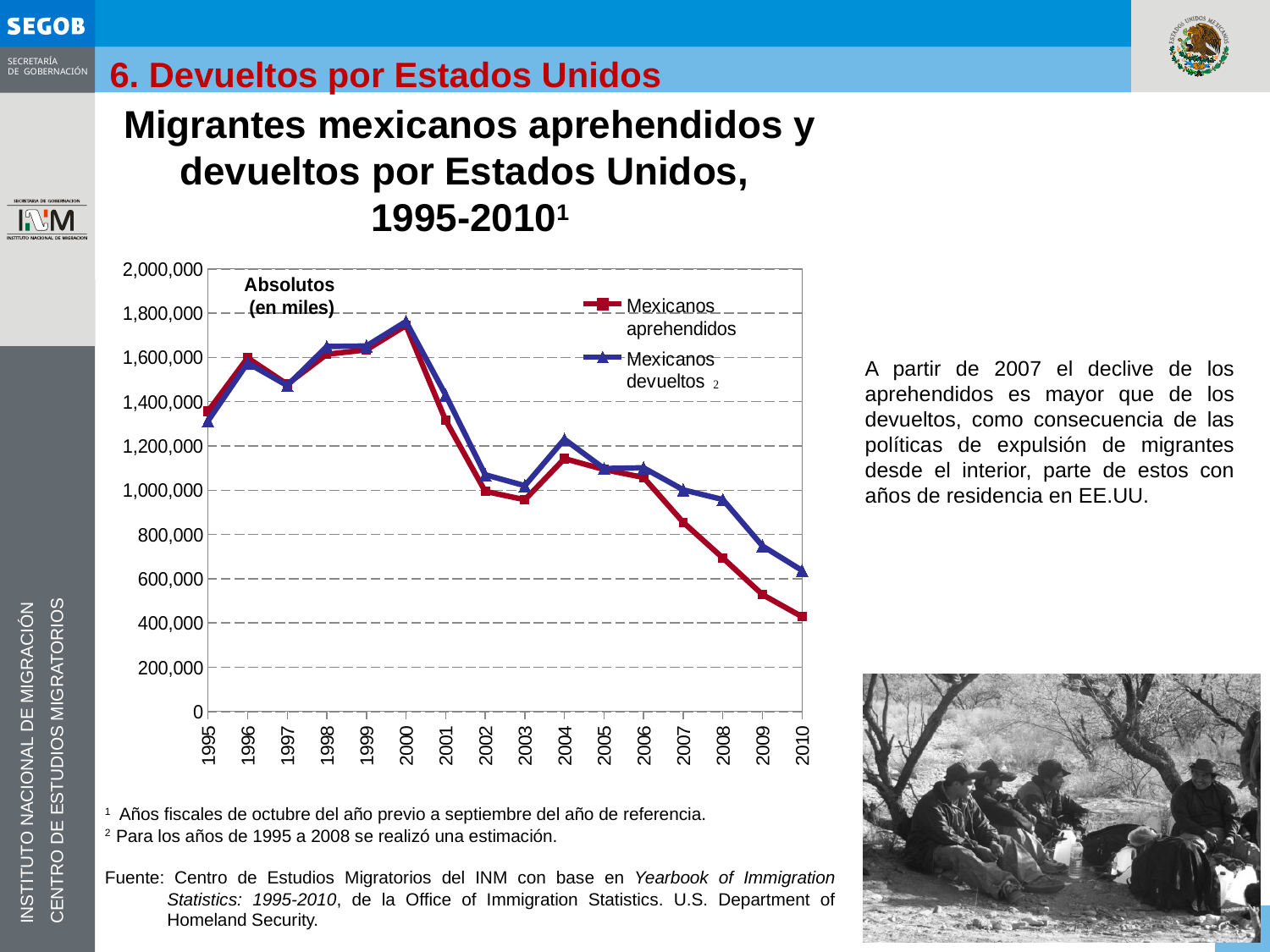
In 2010, which series has the larger value: 'Mexicanos aprehendidos' or 'Mexicanos devueltos'? Mexicanos devueltos Which series is drawn in red on the chart? Mexicanos aprehendidos Is the value for 'Mexicanos devueltos' in 2004 greater or less than 1,000,000? greater Is the value for 'Mexicanos aprehendidos' in 2000 greater or less than 1,600,000? greater In which year does the 'Mexicanos aprehendidos' series reach its highest value? 2000 From 2007 to 2010, do the values of the 'Mexicanos aprehendidos' series rise or fall? fall Is the value for 'Mexicanos aprehendidos' in 2010 greater or less than 600,000? less How many years are plotted along the x axis of the chart? 16 For 'Mexicanos aprehendidos', which year has the larger value: 1996 or 1997? 1996 How many series does the chart's legend list? 2 In which year does the 'Mexicanos devueltos' series reach its lowest value? 2010 What kind of chart is shown on the slide? line chart